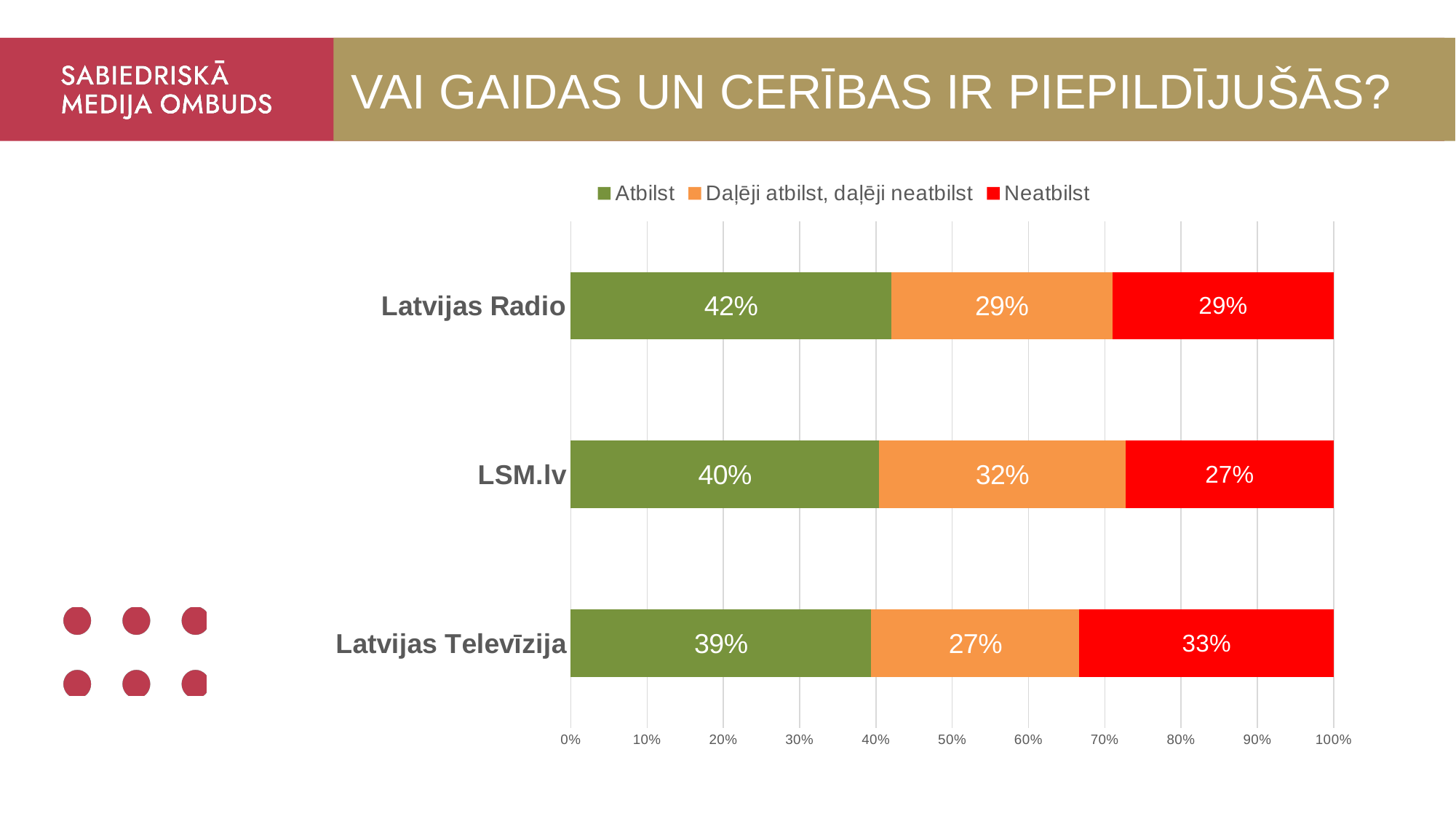
How many series does the legend list? 3 Which is larger: the "Daļēji atbilst, daļēji neatbilst" value for LSM.lv or for Latvijas Televīzija? LSM.lv How many categories are shown on the chart? 3 What is the "Neatbilst" value for Latvijas Televīzija? 33% Which category has the highest "Atbilst" value? Latvijas Radio What is the difference between the "Neatbilst" values for Latvijas Televīzija and LSM.lv? 6% What kind of chart is shown on the slide? Stacked bar chart What is the total of the stacked bar for Latvijas Radio? 100% What is the "Atbilst" value for Latvijas Radio? 42% What is the "Daļēji atbilst, daļēji neatbilst" value for LSM.lv? 32% What colour represents the "Neatbilst" series? Red Which category has the lowest "Neatbilst" value? LSM.lv